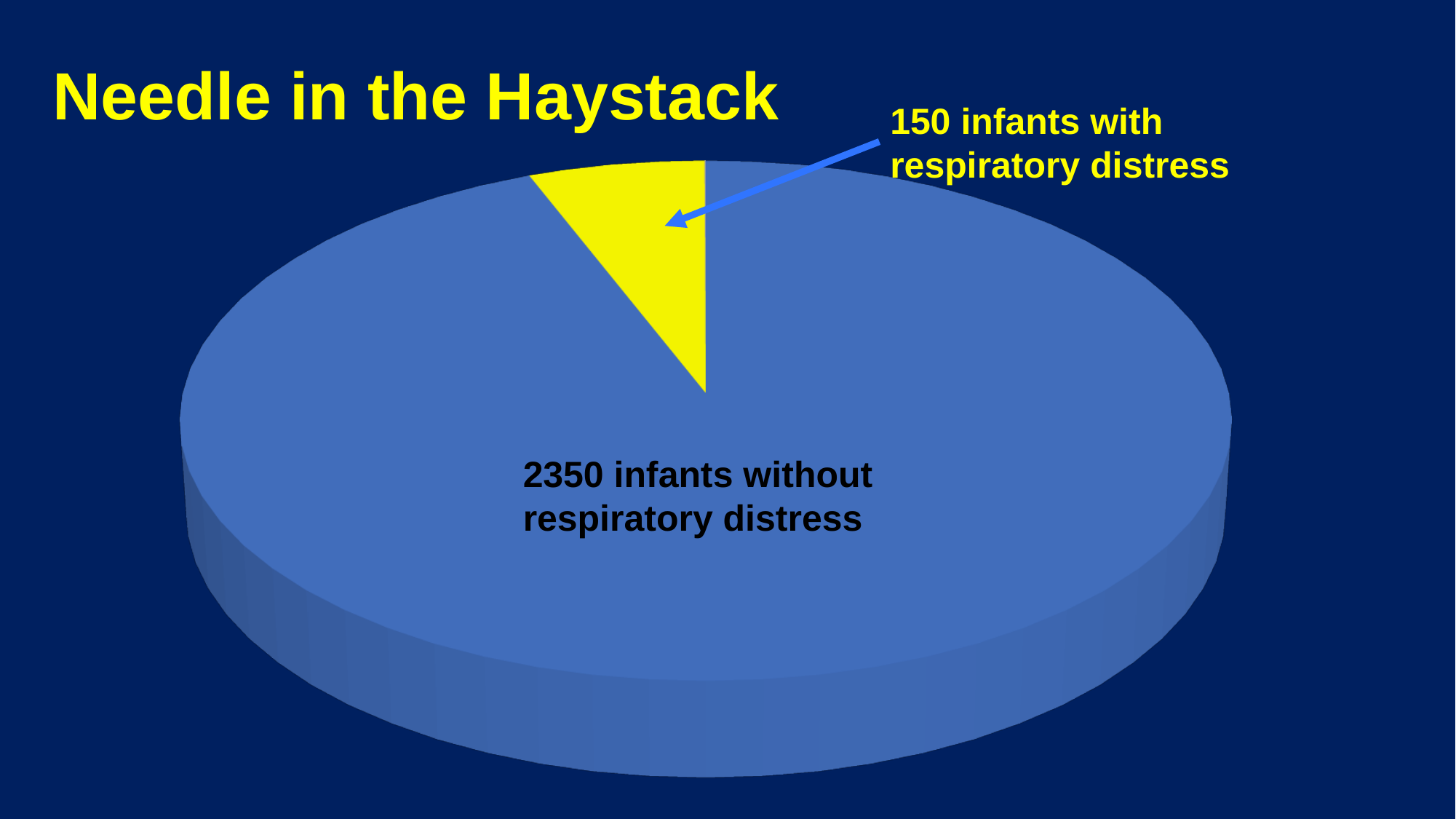
What share of the pie do the infants without respiratory distress represent? 94% How many slices does the pie chart have? 2 How many infants without respiratory distress does the pie chart show? 2350 Is the number of infants with respiratory distress larger or smaller than the number without? smaller What colour is the slice for infants with respiratory distress? yellow What is the difference between the number of infants without respiratory distress and the number with respiratory distress? 2200 What share of the pie do the infants with respiratory distress represent? 6% How many infants with respiratory distress does the pie chart show? 150 Which slice of the pie chart is the smallest? infants with respiratory distress Which slice of the pie chart is the largest? infants without respiratory distress What kind of chart is shown on the slide? pie chart What is the total number of infants represented in the pie chart? 2500